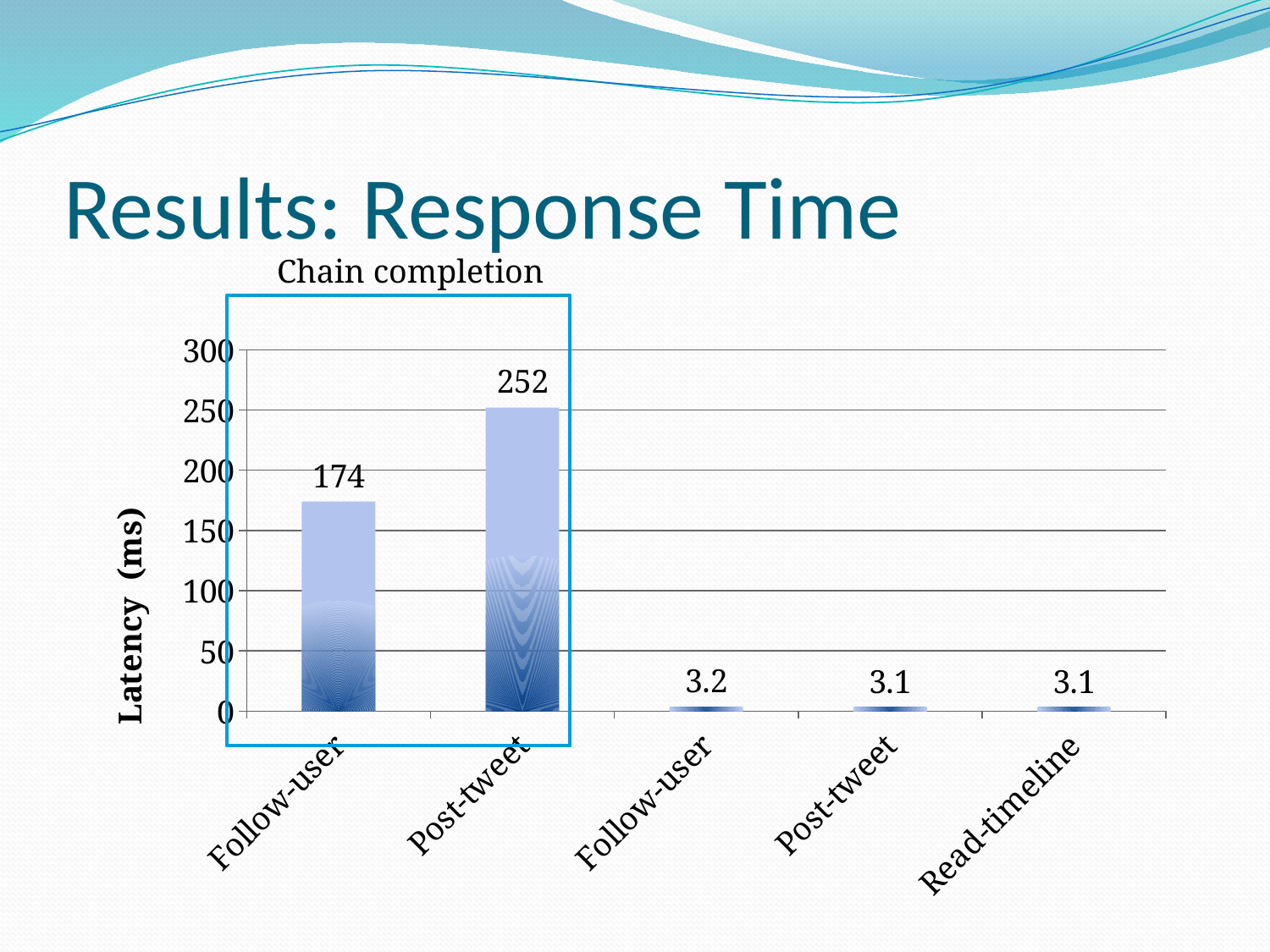
What is the latency for the Follow-user bar inside the Chain completion box? 174 What is the difference in latency between the Chain completion Post-tweet bar and the Chain completion Follow-user bar? 78 What is the label of the y axis? Latency (ms) What label appears above the box enclosing the first two bars? Chain completion What is the latency for the Follow-user bar outside the Chain completion box (the third bar)? 3.2 How many bars are plotted in the chart? 5 What is the latency for the Read-timeline bar? 3.1 What kind of chart is shown on the slide? bar chart What is the latency for the Post-tweet bar inside the Chain completion box? 252 Which bar has the highest latency? Post-tweet (Chain completion) Which is larger: the Chain completion Follow-user latency or the Chain completion Post-tweet latency? Post-tweet Is the latency for the Chain completion Post-tweet bar greater or less than 200? greater